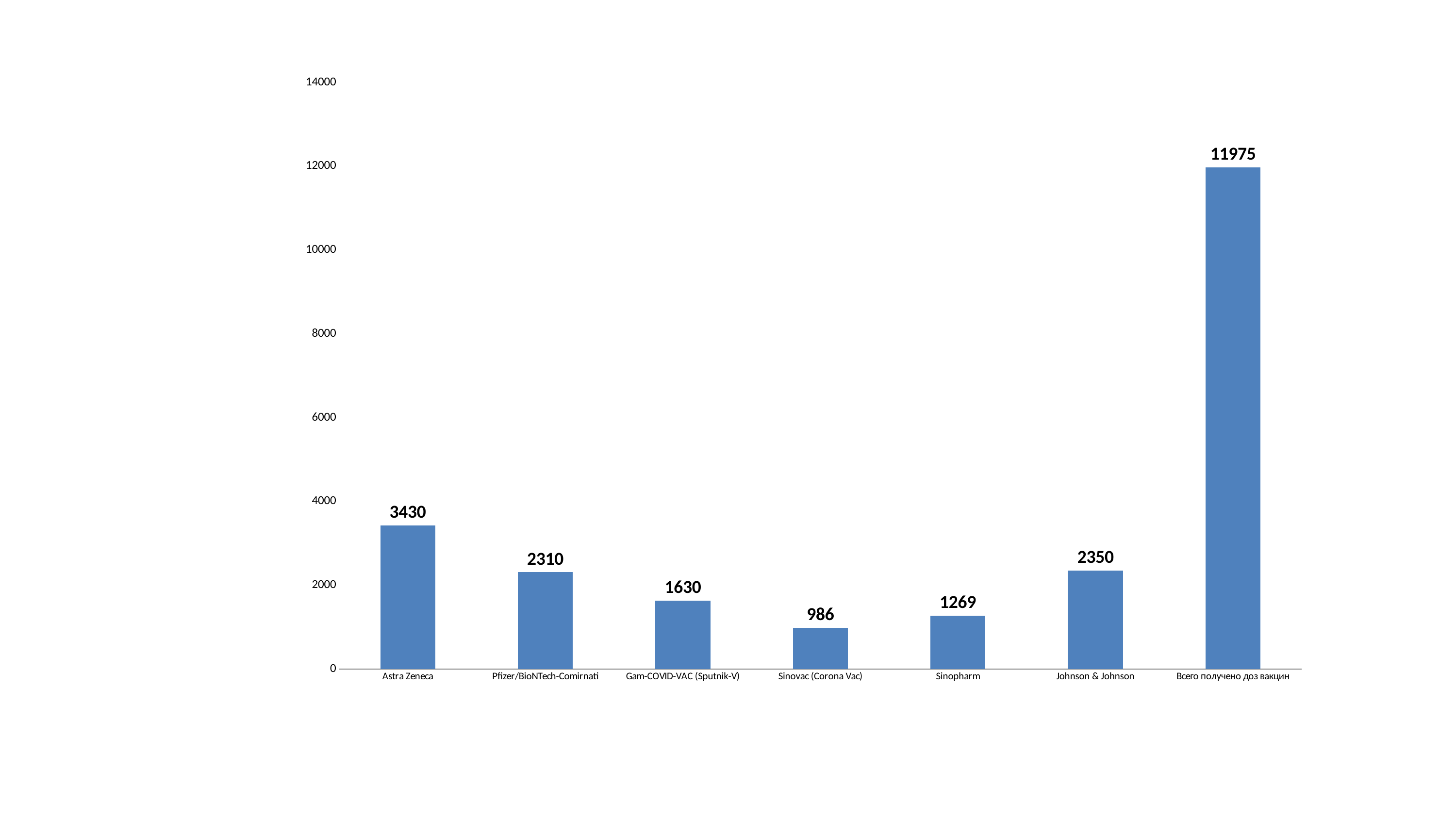
Which is larger, the value for Sinopharm or the value for Gam-COVID-VAC (Sputnik-V)? Gam-COVID-VAC (Sputnik-V) What is the value for Pfizer/BioNTech-Comirnati? 2310 What is the difference between the values for Astra Zeneca and Johnson & Johnson? 1080 What kind of chart is shown on the slide? bar chart How many categories are shown on the x axis? 7 Is the value for Johnson & Johnson greater or less than 2000? greater What is the value for Всего получено доз вакцин? 11975 What is the value for Astra Zeneca? 3430 What is the value for Sinovac (Corona Vac)? 986 What is the difference between the values for Pfizer/BioNTech-Comirnati and Sinopharm? 1041 Which category has the lowest value? Sinovac (Corona Vac) Which category has the highest value? Всего получено доз вакцин